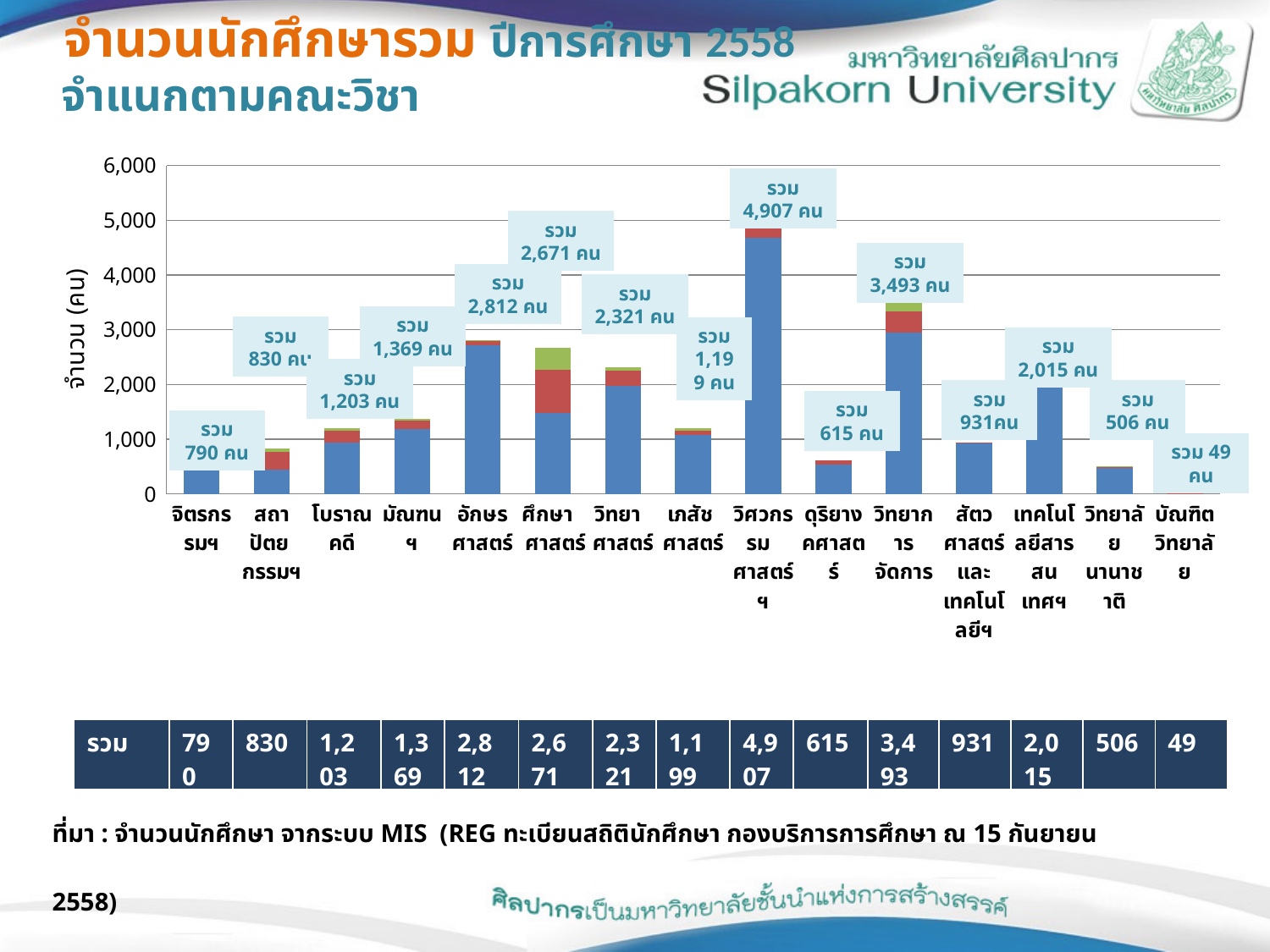
What kind of chart is shown on the slide? stacked bar chart What is the total number of students shown for วิทยาการจัดการ? 3,493 คน What is the label of the y axis? จำนวน (คน) Is the total for ดุริยางคศาสตร์ greater or less than 1,000? less What is the total number of students shown for เภสัชศาสตร์? 1,199 คน Which faculty has the lowest total number of students? บัณฑิตวิทยาลัย What is the difference between the totals for อักษรศาสตร์ and ศึกษาศาสตร์? 141 How many faculties (categories) are shown on the x axis? 15 Which has a larger total, วิทยาศาสตร์ or เทคโนโลยีสารสนเทศฯ? วิทยาศาสตร์ Which faculty has the highest total number of students? วิศวกรรมศาสตร์ฯ What is the total number of students shown for วิศวกรรมศาสตร์ฯ? 4,907 คน What is the total for สถาปัตยกรรมฯ according to the table below the chart? 830